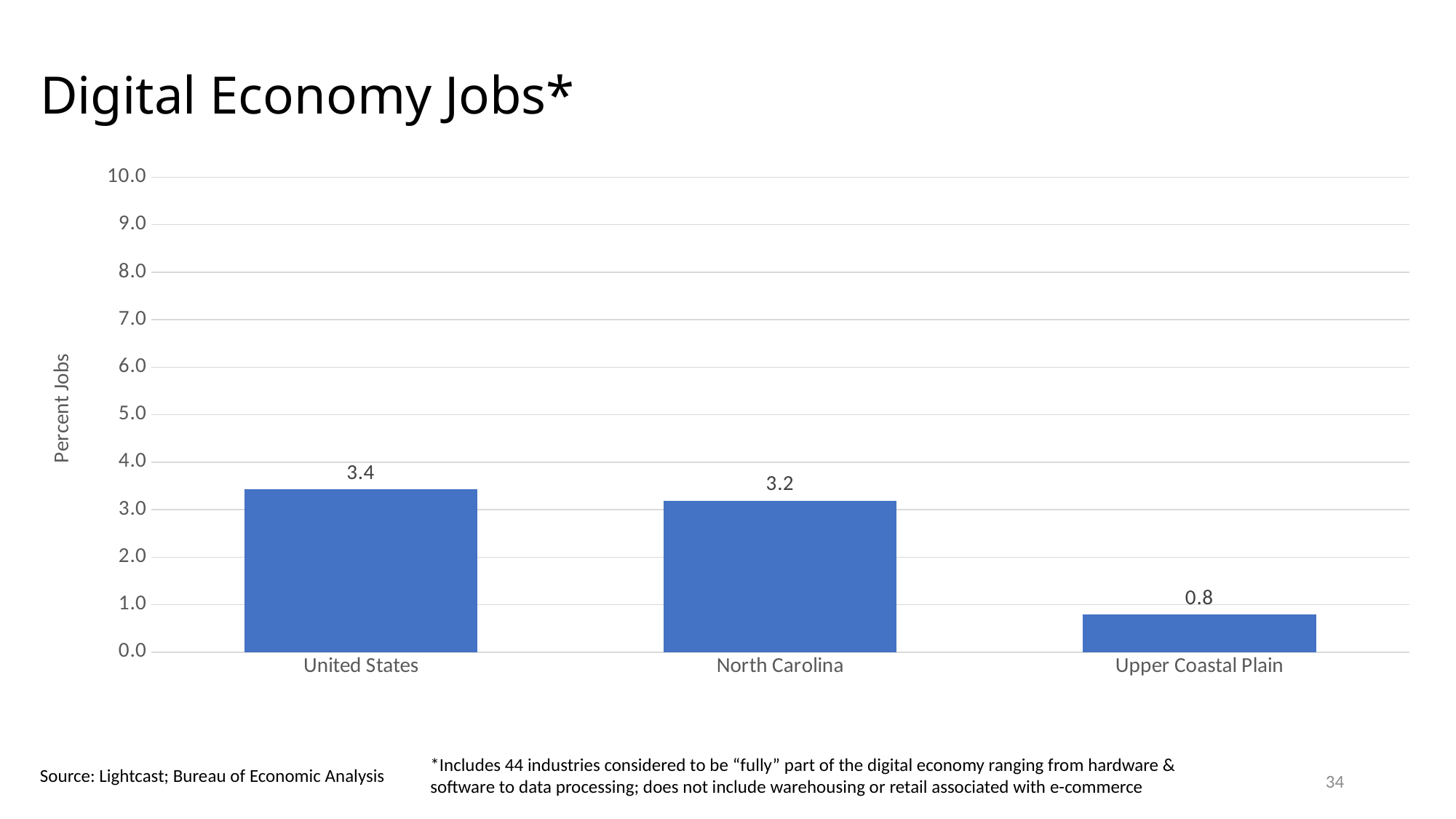
Which category has the lowest value? Upper Coastal Plain What is the value for North Carolina? 3.2 What is the label of the vertical axis? Percent Jobs How many categories are shown on the chart? 3 What is the value for Upper Coastal Plain? 0.8 What kind of chart is shown on the slide? bar chart What is the difference between the values for North Carolina and Upper Coastal Plain? 2.4 Which category has the highest value? United States Which is larger, the value for North Carolina or the value for Upper Coastal Plain? North Carolina What is the value for United States? 3.4 Is the value for Upper Coastal Plain greater or less than 1.0? less What is the difference between the values for United States and Upper Coastal Plain? 2.6